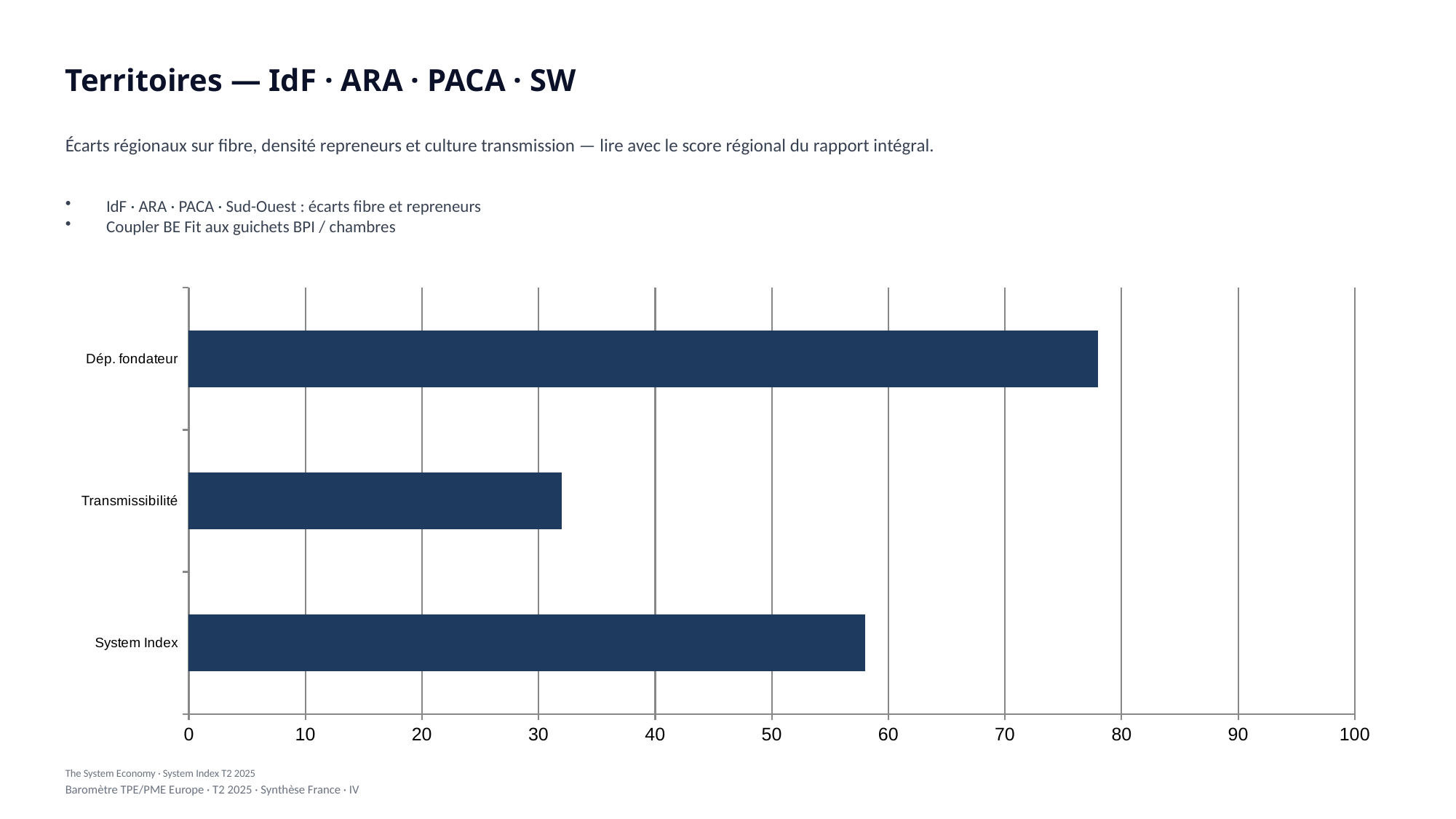
Is the value for System Index greater or less than 50? greater What is the maximum value shown on the horizontal axis of the bar chart? 100 Is the value for Transmissibilité greater or less than 40? less Is the value for System Index greater or less than 60? less Which category has the lowest value in the bar chart? Transmissibilité Which is larger, the value for Dép. fondateur or the value for System Index? Dép. fondateur Which category has the highest value in the bar chart? Dép. fondateur Which is larger, the value for System Index or the value for Transmissibilité? System Index How many categories are plotted in the bar chart? 3 What is the title of the slide containing the bar chart? Territoires — IdF · ARA · PACA · SW What kind of chart is shown on the slide? bar chart